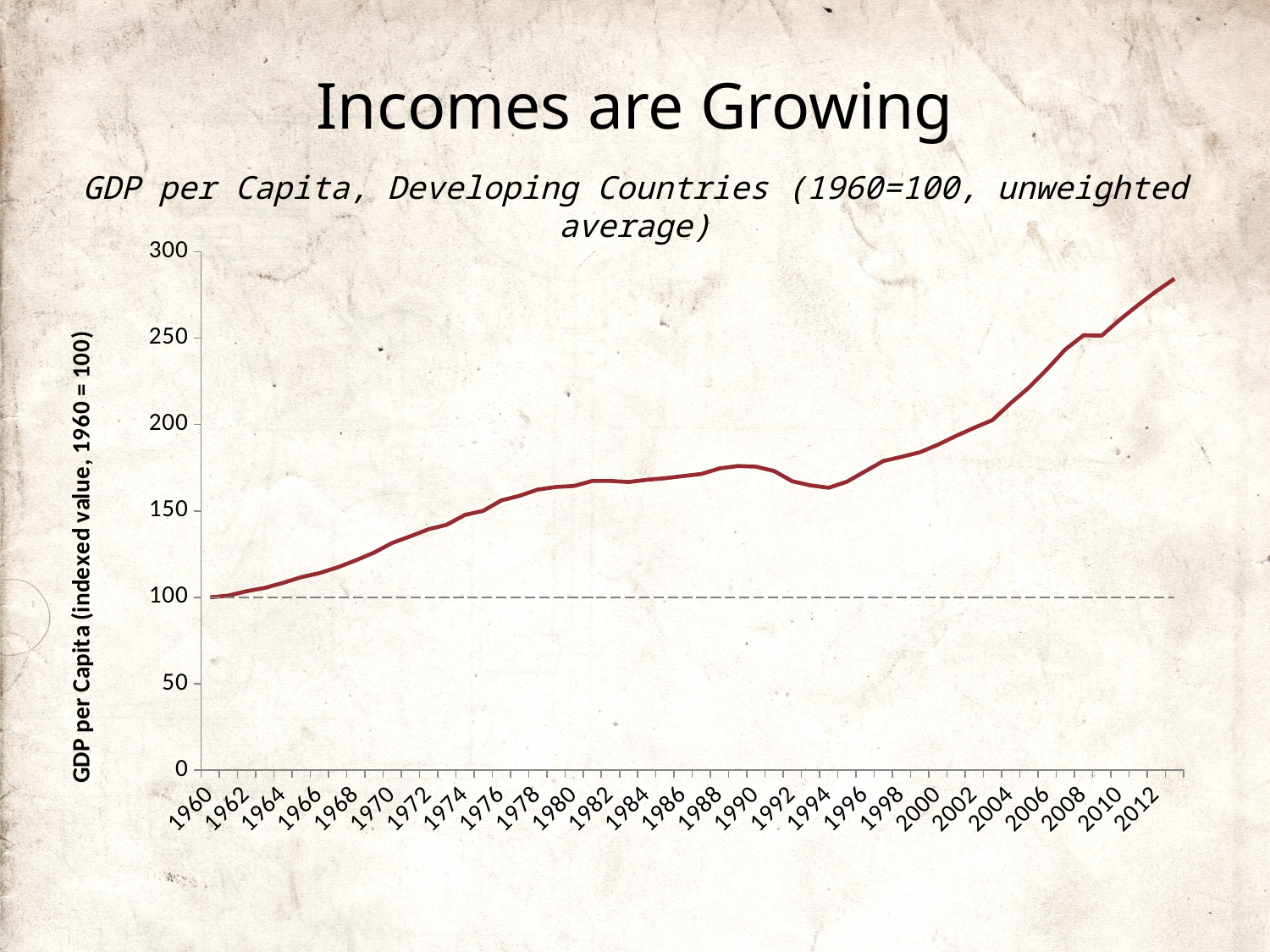
Is the value for 2012 greater or less than 250? greater What is the title of the chart? GDP per Capita, Developing Countries (1960=100, unweighted average) Is the value for 1970 greater or less than 150? less What is the indexed GDP per capita value for 1960? 100 Between 1990 and 1994, does the line rise or fall? fall Is the value for 1980 greater or less than 150? greater Which year has the lowest indexed GDP per capita value? 1960 What is the label of the vertical axis? GDP per Capita (indexed value, 1960 = 100) What kind of chart is shown on the slide? line chart Does the indexed GDP per capita generally rise or fall from 1960 to 2012? rise